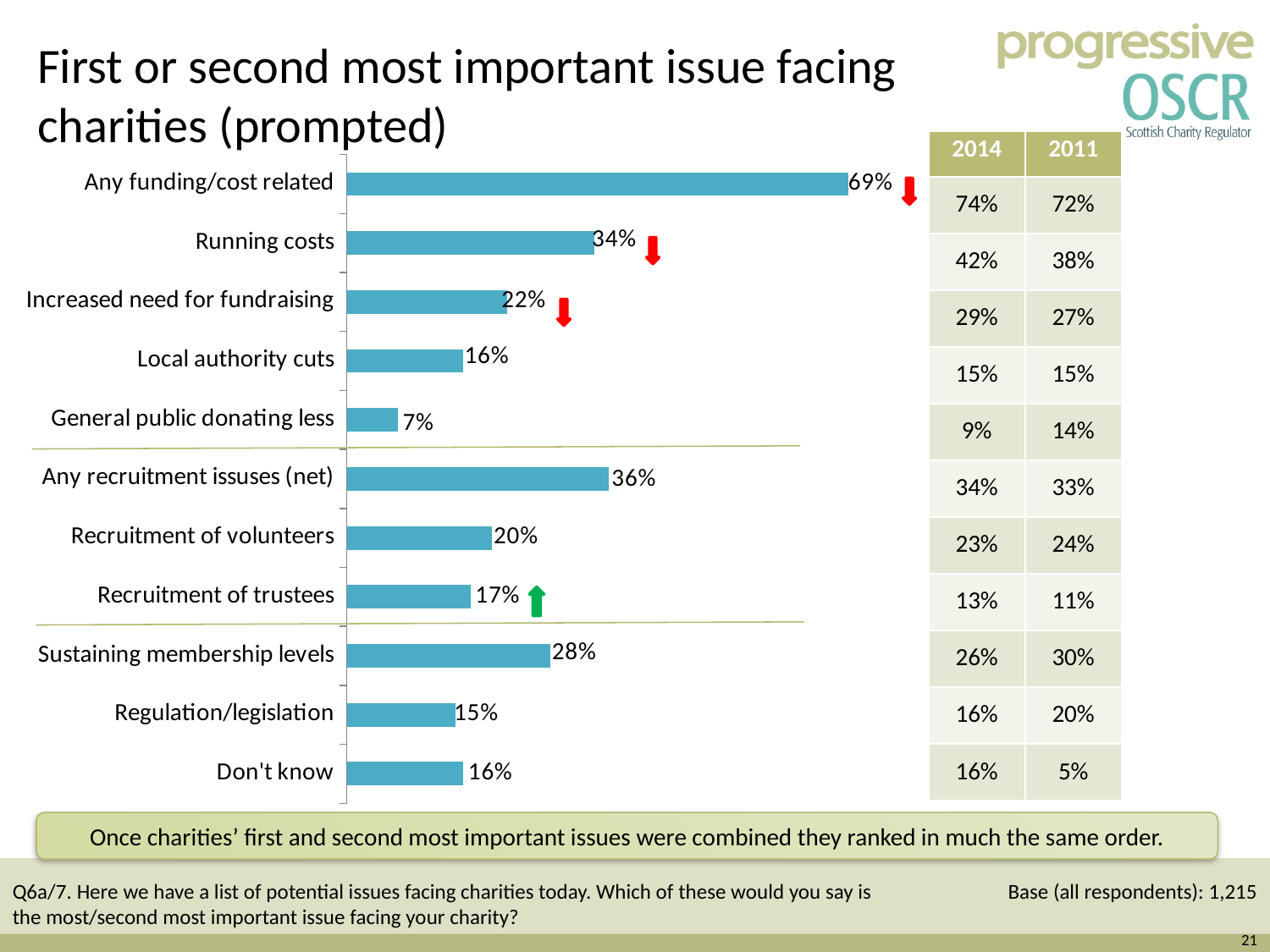
What is the value for Recruitment of trustees? 17% What is the value for Sustaining membership levels? 28% What is the difference between Running costs and Increased need for fundraising? 12% Which category has the lowest value? General public donating less What type of chart is shown on the slide? Bar chart What is the value for Any funding/cost related? 69% Which is larger, Local authority cuts or General public donating less? Local authority cuts Which is larger, Any recruitment issues (net) or Running costs? Any recruitment issues (net) What is the difference between Any recruitment issues (net) and Recruitment of volunteers? 16% Which category has the highest value? Any funding/cost related How many categories are shown in the chart? 11 What is the value for Regulation/legislation? 15%